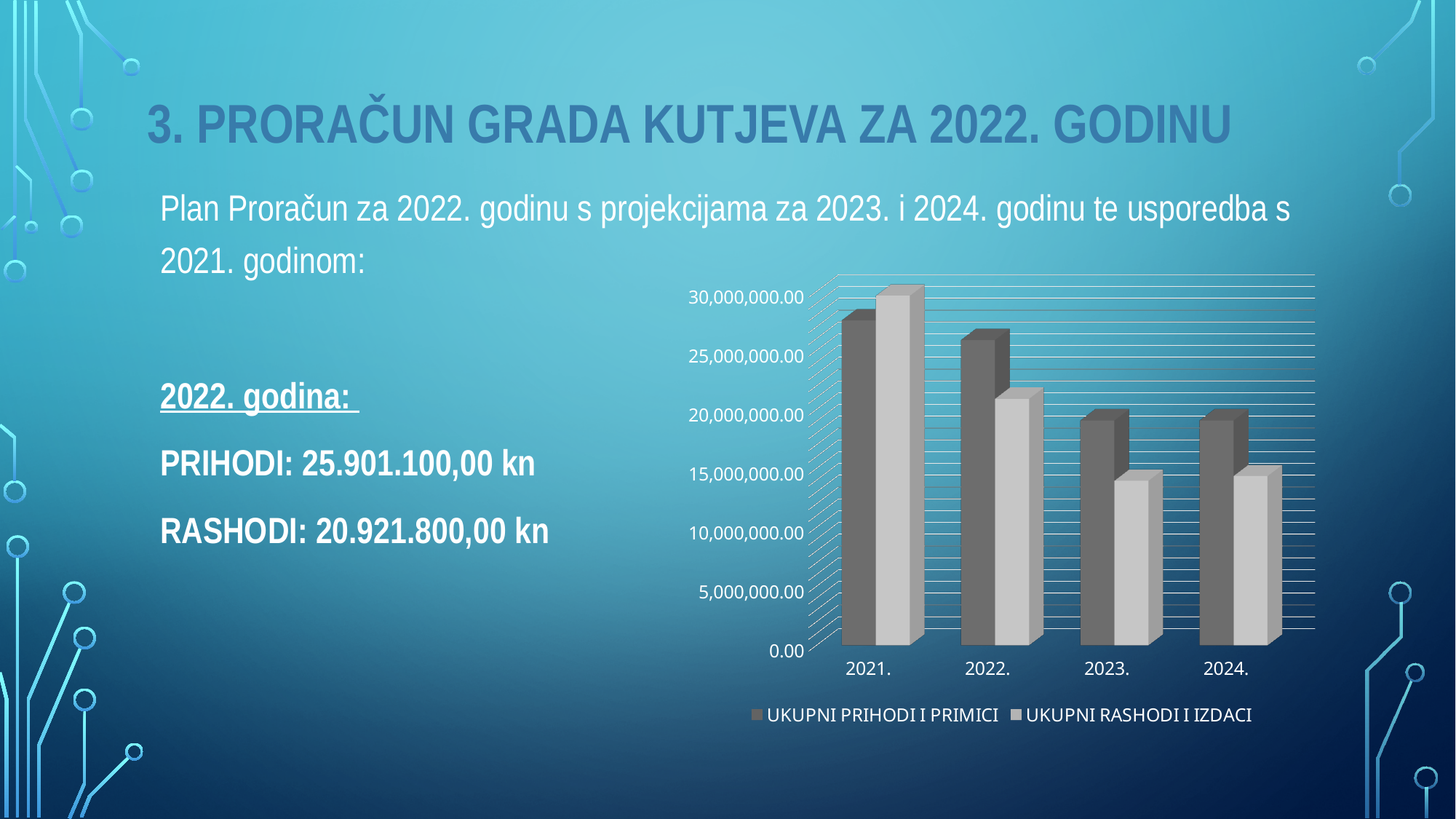
In 2022., which is larger: UKUPNI PRIHODI I PRIMICI or UKUPNI RASHODI I IZDACI? UKUPNI PRIHODI I PRIMICI Does UKUPNI PRIHODI I PRIMICI rise or fall from 2021. to 2024.? fall How many series does the chart legend list? 2 According to the slide, what is the difference between PRIHODI and RASHODI for 2022? 4.979.300,00 kn What kind of chart is shown on the slide? bar chart Which year has the highest value for UKUPNI PRIHODI I PRIMICI? 2021. How many years are shown on the x axis of the chart? 4 Is the value for UKUPNI PRIHODI I PRIMICI in 2021. greater or less than 25,000,000.00? greater Is the value for UKUPNI RASHODI I IZDACI in 2023. greater or less than 10,000,000.00? greater Which year has the highest value for UKUPNI RASHODI I IZDACI? 2021. Is the value for UKUPNI RASHODI I IZDACI in 2022. greater or less than 25,000,000.00? less In 2021., which is larger: UKUPNI PRIHODI I PRIMICI or UKUPNI RASHODI I IZDACI? UKUPNI RASHODI I IZDACI